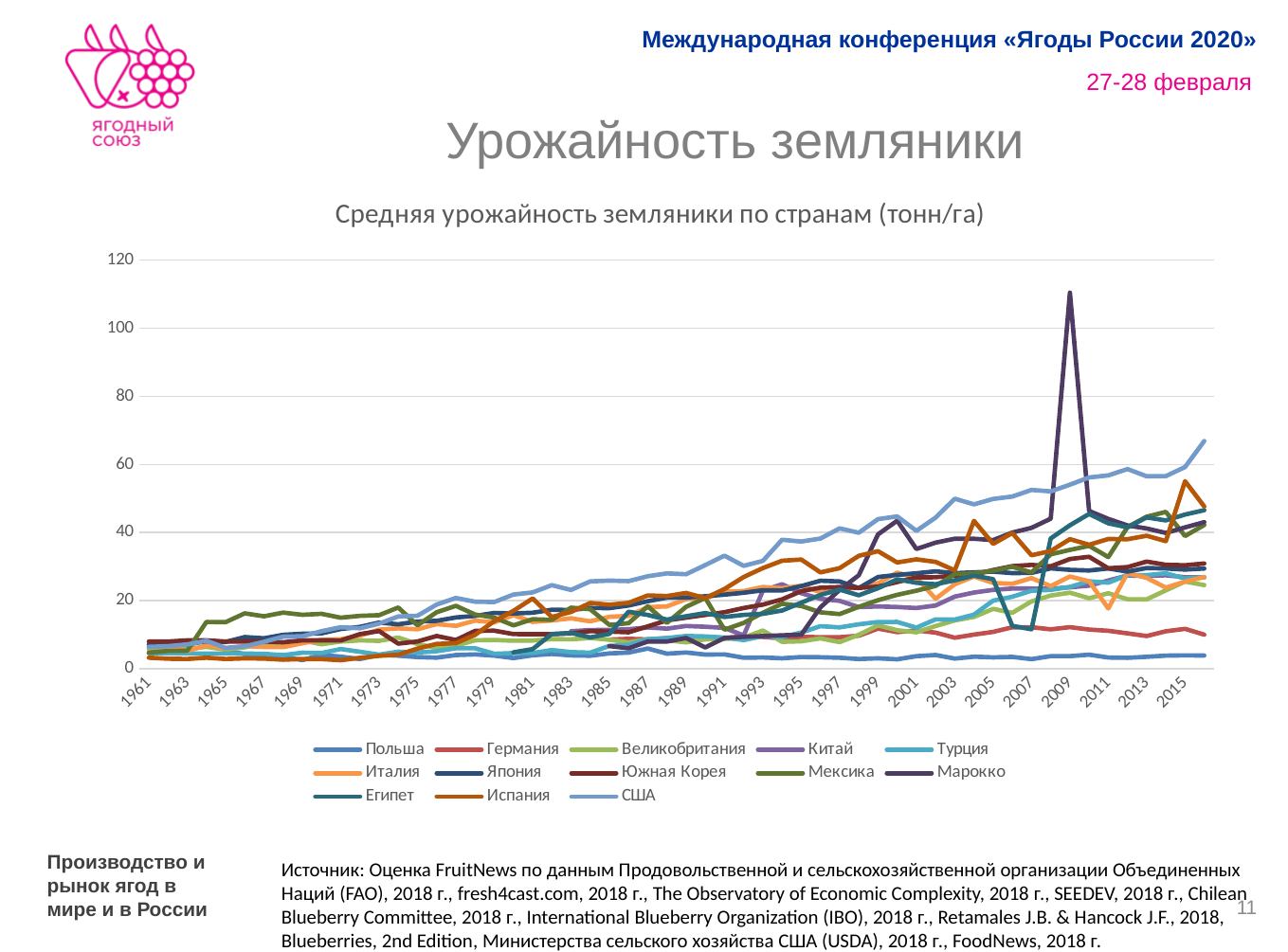
Is the value for Польша in 2015 greater or less than 20? less Which country has the highest value at the right end of the chart (2016)? США What kind of chart is shown on the slide? line chart Which country's line shows the sharp spike above 100 around 2009? Марокко Which is larger in 2015, the value for США or the value for Германия? США Is the value for США at the right end of the chart (2016) greater or less than 60? greater What is the title of the chart? Средняя урожайность земляники по странам (тонн/га) Is the peak value for Марокко around 2009 greater or less than 100? greater Which country has the lowest value at the right end of the chart (2016)? Польша How many series does the legend list? 13 Does the line for США generally rise or fall from 1961 to 2016? rise